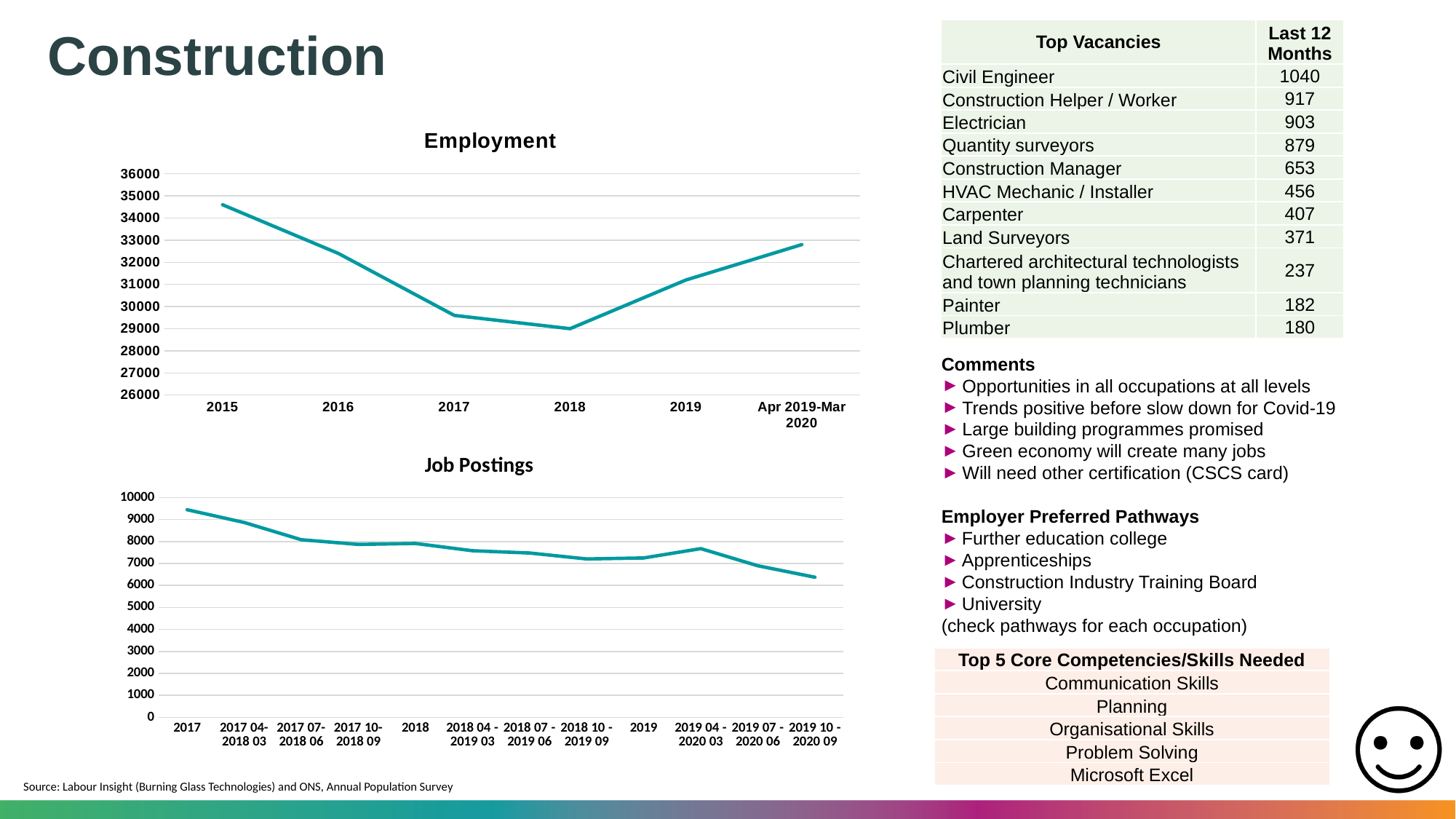
What type of chart is the Employment chart? line chart On the Job Postings chart, which period has the lowest number of job postings? 2019 10 - 2020 09 How many data points are plotted on the Employment chart? 6 On the Employment chart, is the value for 2018 greater or less than 30000? less On the Employment chart, which is larger, the value for 2016 or the value for 2019? 2016 On the Employment chart, which year has the highest employment? 2015 On the Job Postings chart, is the value for 2017 greater or less than 9000? greater On the Employment chart, which year has the lowest employment? 2018 On the Job Postings chart, which period has the highest number of job postings? 2017 On the Employment chart, is the value for Apr 2019-Mar 2020 greater or less than 32000? greater How many data points are plotted on the Job Postings chart? 12